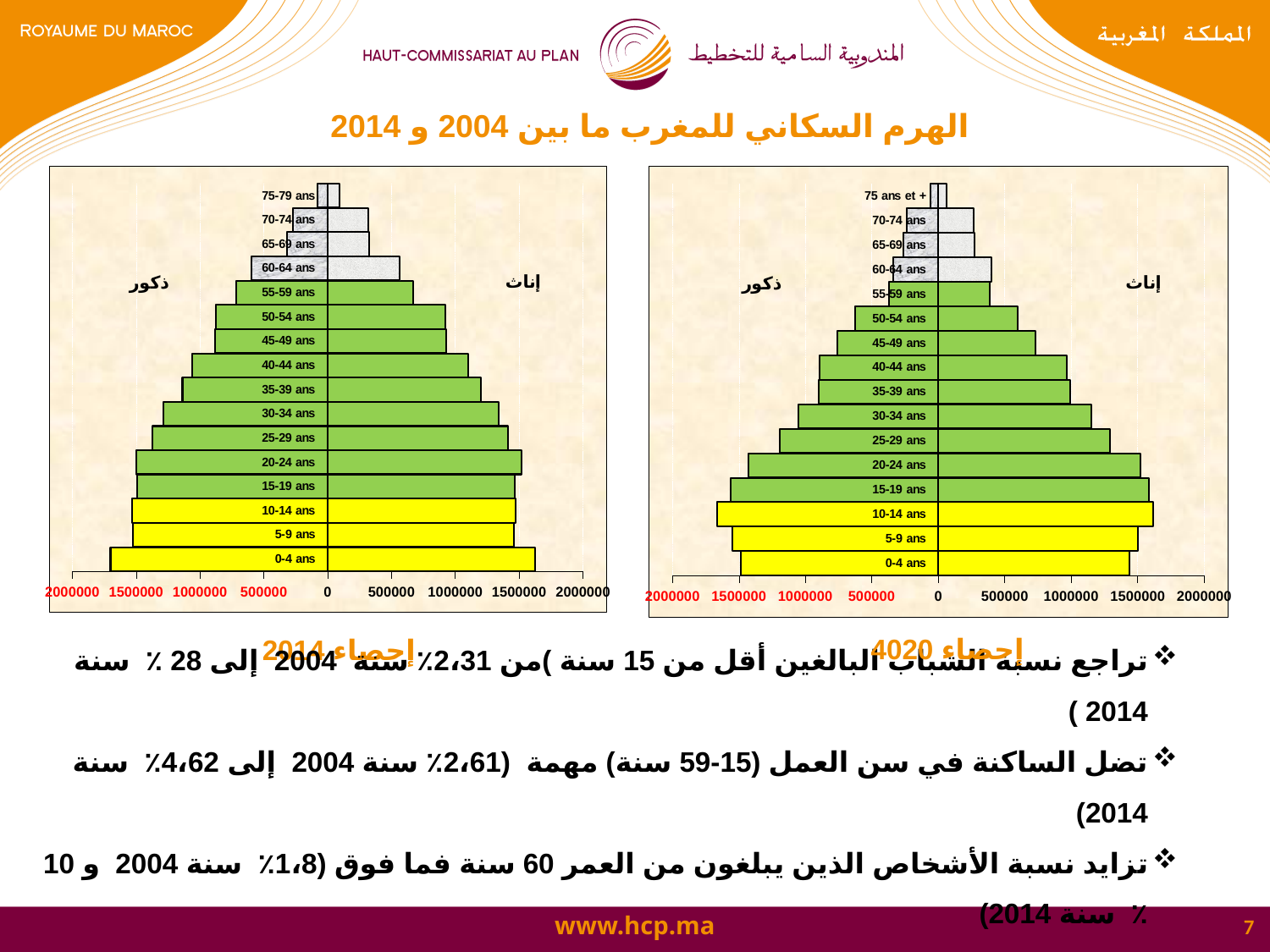
What kind of chart is used on the left (2004) side of the slide? Bar chart (population pyramid) In the left (2004) pyramid, is the male (ذكور) value for 20-24 ans greater or less than 1000000? greater What is the title of the slide's charts? الهرم السكاني للمغرب ما بين 2004 و 2014 In the right (2014) pyramid, is the male (ذكور) value for 10-14 ans greater or less than 1000000? greater In the right (2014) pyramid, which is larger, the male bar for 10-14 ans or the male bar for 40-44 ans? 10-14 ans How many age groups are shown in the left (2004) pyramid? 16 In the left (2004) pyramid, which age group has the narrowest bars? 75-79 ans In the right (2014) pyramid, which age group has the widest bars? 10-14 ans In the left (2004) pyramid, is the female (إناث) value for 65-69 ans greater or less than 500000? less How many age groups are shown in the right (2014) pyramid? 16 In the left (2004) pyramid, which age group has the widest bars? 0-4 ans In the right (2014) pyramid, which age group has the narrowest bars? 75 ans et +